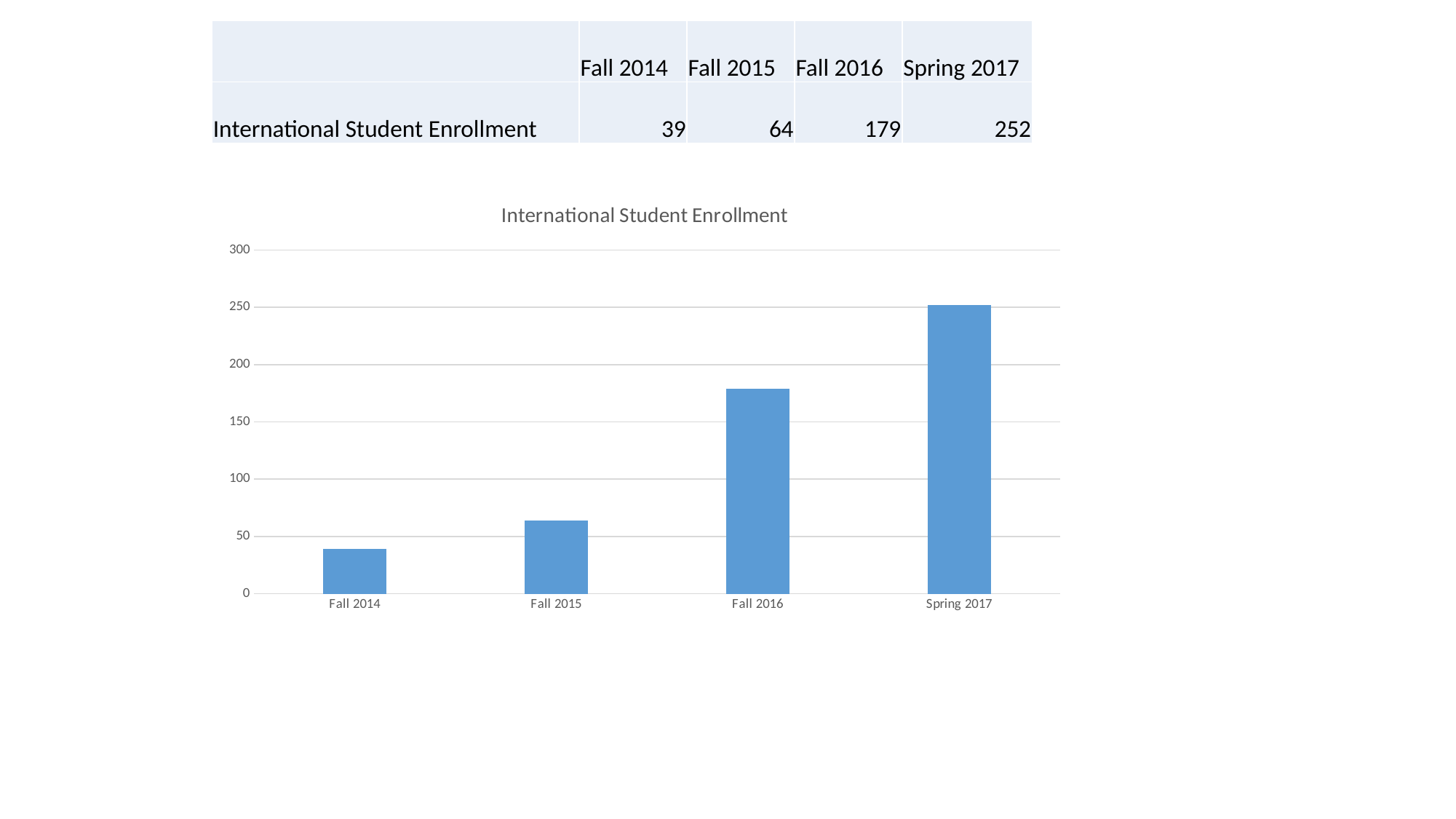
What kind of chart is shown on the slide? Bar chart What is the difference in International Student Enrollment between Spring 2017 and Fall 2016? 73 Which term has the highest International Student Enrollment? Spring 2017 Which term has the lowest International Student Enrollment? Fall 2014 Is the International Student Enrollment for Fall 2016 greater or less than 150? greater What is the International Student Enrollment for Fall 2015? 64 What is the difference in International Student Enrollment between Fall 2015 and Fall 2014? 25 Which is larger, the International Student Enrollment for Fall 2016 or for Fall 2015? Fall 2016 What is the International Student Enrollment for Fall 2016? 179 What is the International Student Enrollment for Fall 2014? 39 What is the International Student Enrollment for Spring 2017? 252 How many terms are shown on the x axis of the chart? 4